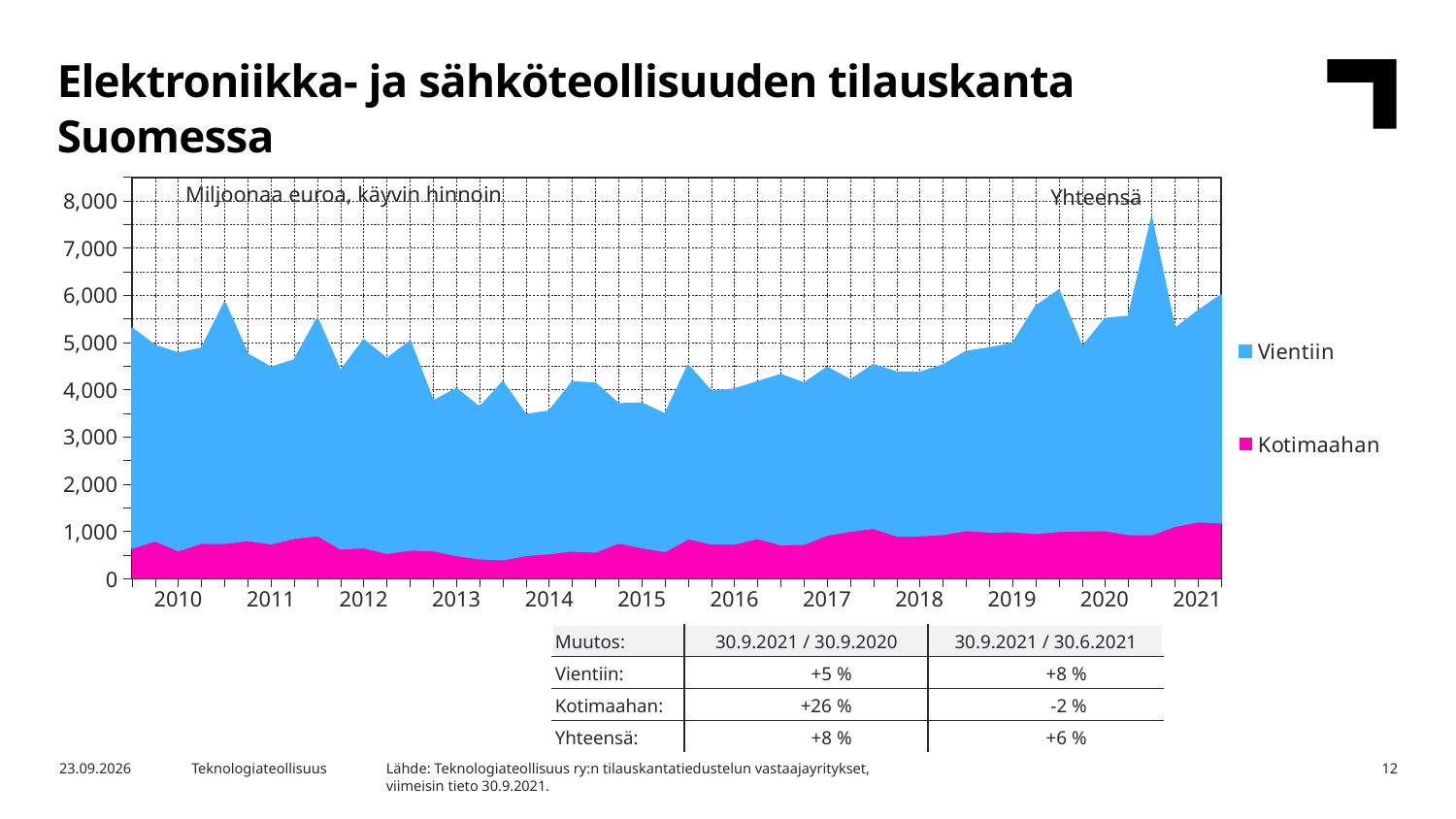
What kind of chart is shown on the slide? area chart From 2016 to 2019, does the total (Yhteensä) rise or fall? rise In which year does the total (Yhteensä) reach its highest peak? 2020 What is the title of the chart on the slide? Elektroniikka- ja sähköteollisuuden tilauskanta Suomessa Is the highest peak of the total (Yhteensä) greater or less than 7,000? greater Is the Kotimaahan value at the end of 2021 greater or less than 2,000? less How many years are labelled on the x axis? 12 Which series is larger throughout the chart, Vientiin or Kotimaahan? Vientiin How many series does the legend list? 2 What are the two series named in the legend? Vientiin and Kotimaahan